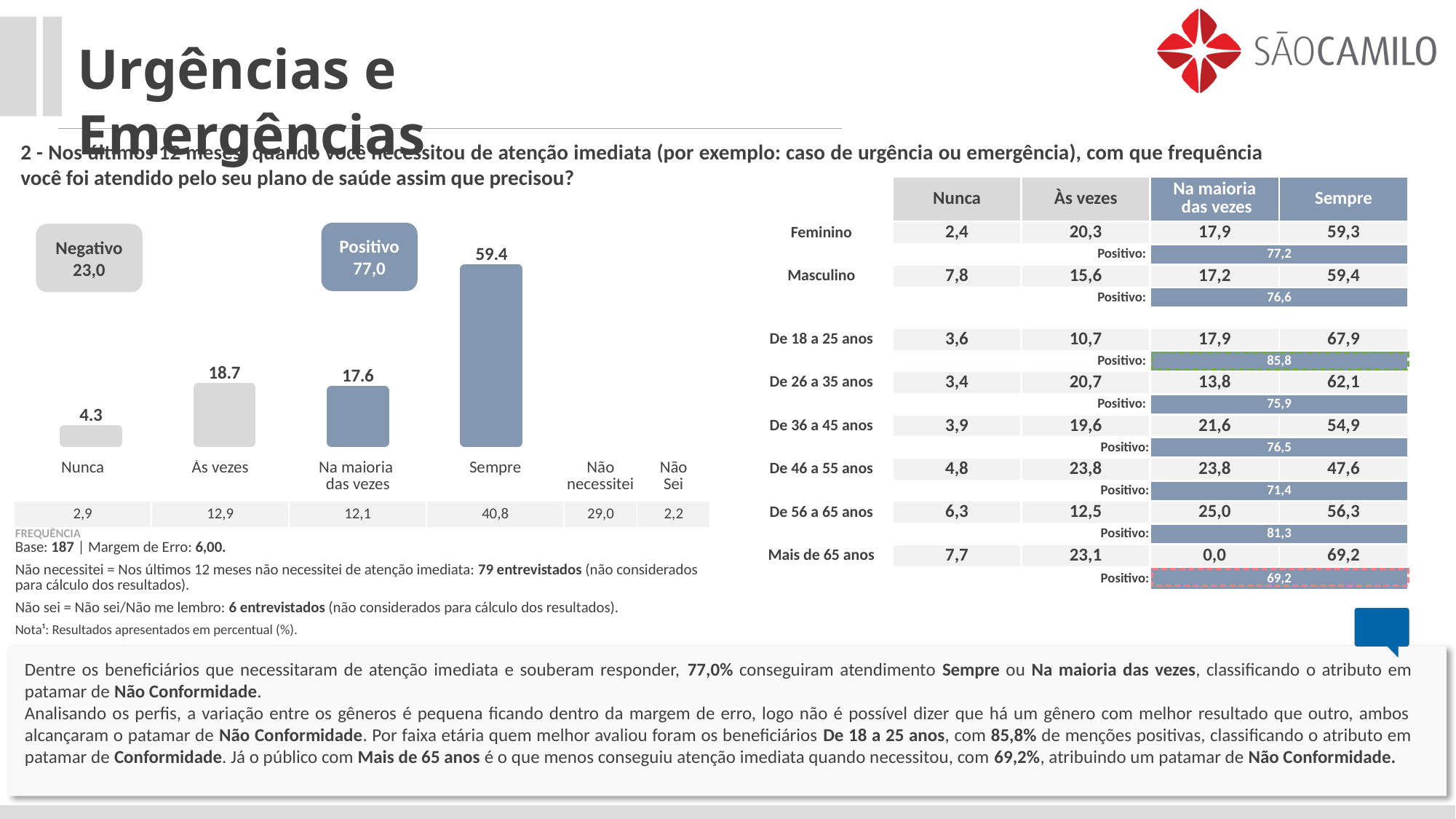
What is the value for Sempre in the bar chart? 59.4 What kind of chart is shown on the left of the slide? bar chart Which category has the highest bar in the bar chart? Sempre What is the difference between the values for Às vezes and Na maioria das vezes in the bar chart? 1.1 Which category has the lowest bar in the bar chart? Nunca What is the difference between the values for Sempre and Nunca in the bar chart? 55.1 What value is shown in the Positivo box above the bar chart? 77,0 What is the value for Na maioria das vezes in the bar chart? 17.6 What is the value for Às vezes in the bar chart? 18.7 How many bars are plotted in the bar chart? 4 What is the value for Nunca in the bar chart? 4.3 Which is larger in the bar chart, the value for Às vezes or the value for Na maioria das vezes? Às vezes